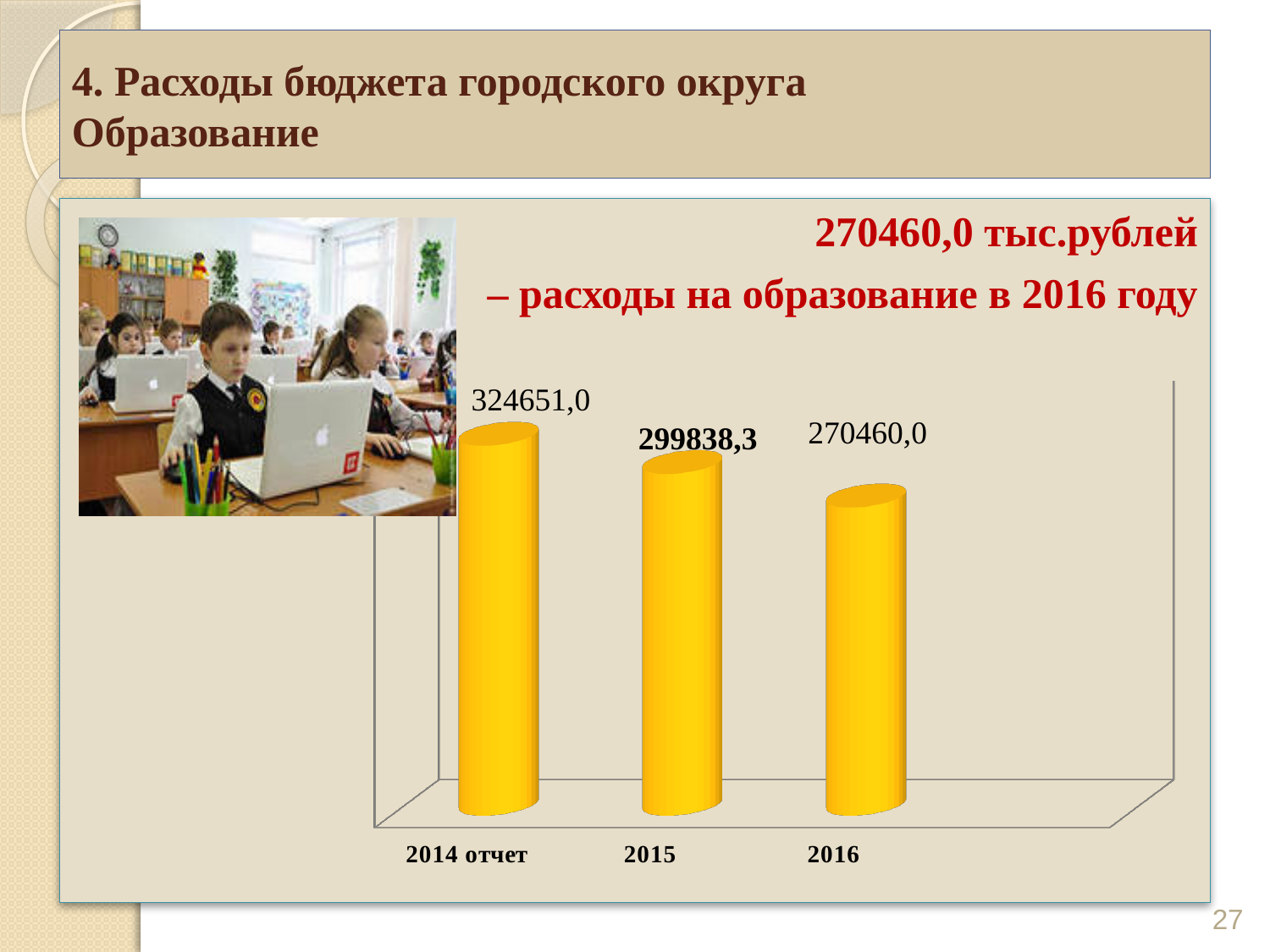
What is the difference between the values for 2014 отчет and 2015? 24812,7 What is the value shown for 2016? 270460,0 Which is larger, the value for 2015 or the value for 2016? 2015 What is the difference between the values for 2014 отчет and 2016? 54191,0 What is the value shown for 2014 отчет? 324651,0 Which category has the highest value? 2014 отчет What kind of chart is shown on the slide? bar chart Which category has the lowest value? 2016 What is the value shown for 2015? 299838,3 How many categories are shown on the chart? 3 Do the values rise or fall from 2014 отчет to 2016? fall What is the difference between the values for 2015 and 2016? 29378,3